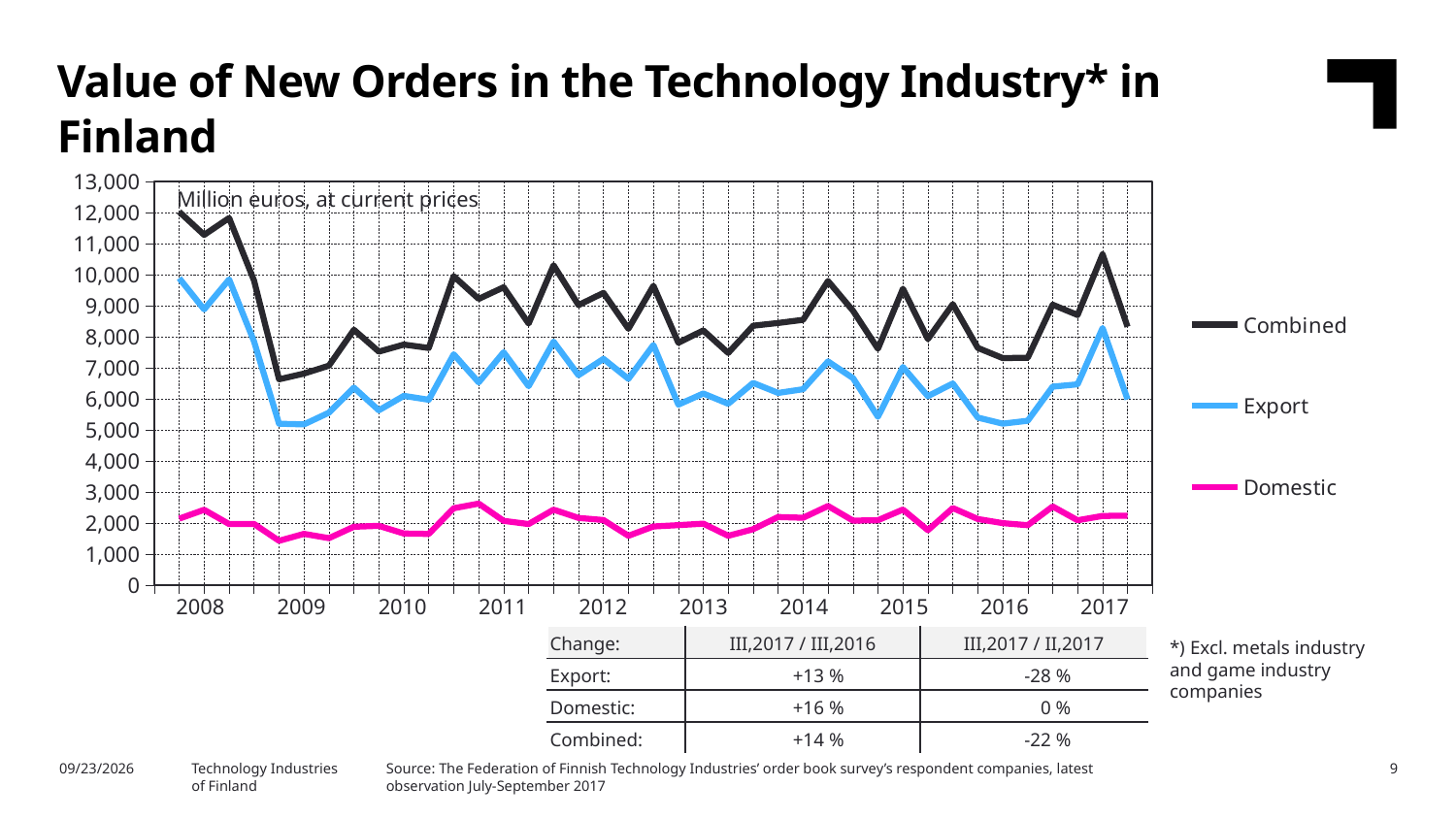
Does the Combined series rise or fall from the start of 2008 to the start of 2009? Fall Is the Domestic value at the start of 2008 greater or less than 3,000? less Which series has the lowest values throughout the chart? Domestic Which is larger at the start of 2013, the Export value or the Domestic value? Export Which series has the highest values throughout the chart? Combined How many years are labelled on the x axis? 10 What kind of chart is shown on the slide? Line chart Is the Combined value at its 2017 peak greater or less than 10,000? greater Is the Export value at the start of 2009 greater or less than 6,000? less How many series does the legend list? 3 What unit is stated in the chart's subtitle? Million euros, at current prices